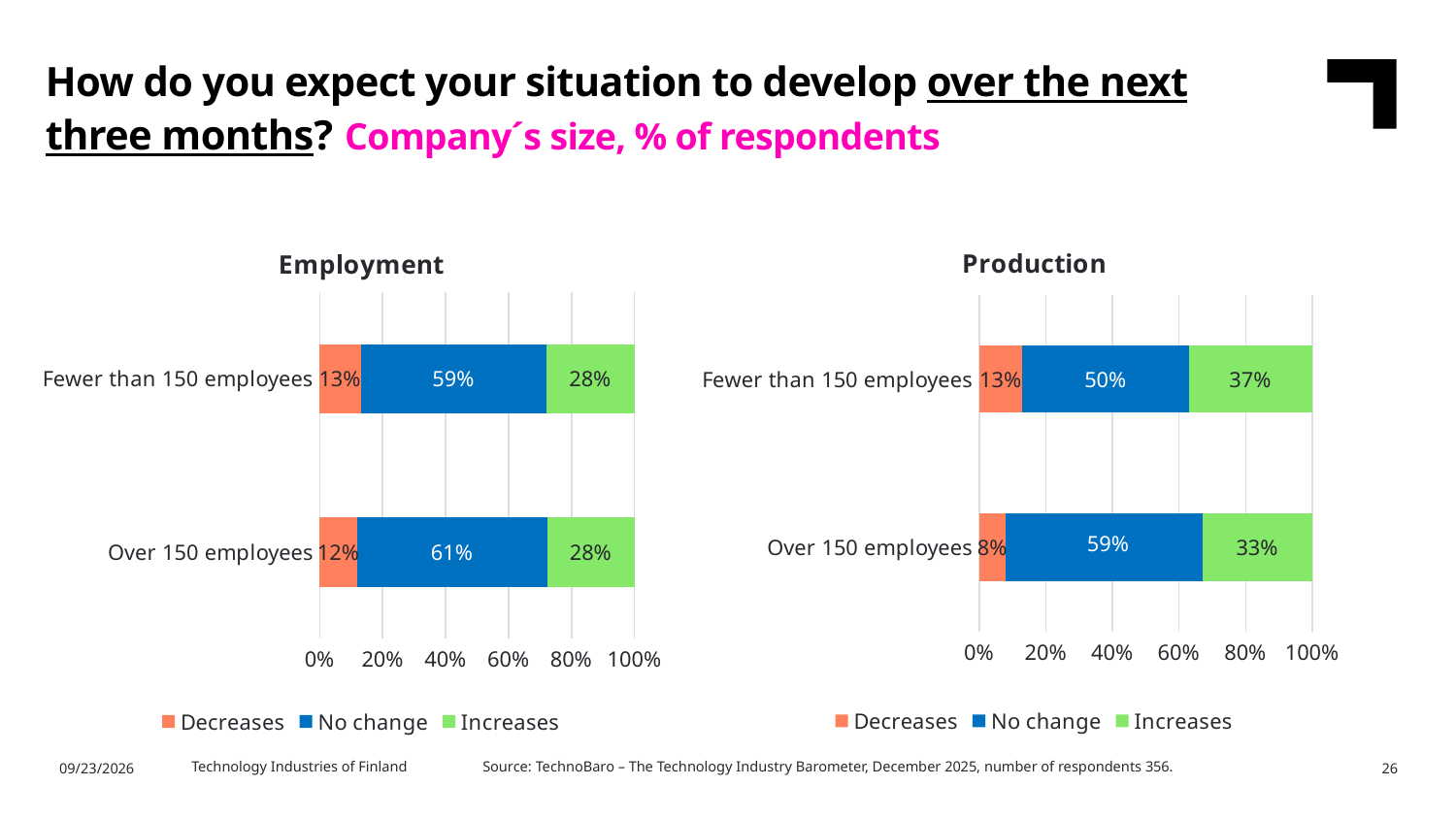
How many series does the legend of the Employment chart list? 3 In the Employment chart, what is the difference between the 'Decreases' shares for fewer than 150 employees and over 150 employees? 1% In the Production chart, what is the total of the stacked bar for over 150 employees? 100% What colour represents 'No change' in the Production chart? Blue How many categories are shown in the Production chart? 2 In the Production chart, which company size has the higher share of respondents expecting increases? Fewer than 150 employees What kind of chart is the Employment chart? Stacked bar chart In the Production chart, what is the difference between the 'No change' shares for over 150 employees and fewer than 150 employees? 9% In the Employment chart, what percentage of respondents from companies with fewer than 150 employees expect no change? 59% In the Production chart, what percentage of respondents from companies with fewer than 150 employees expect decreases? 13% In the Production chart, what percentage of respondents from companies with over 150 employees expect increases? 33% In the Employment chart, what percentage of respondents from companies with over 150 employees expect decreases? 12%